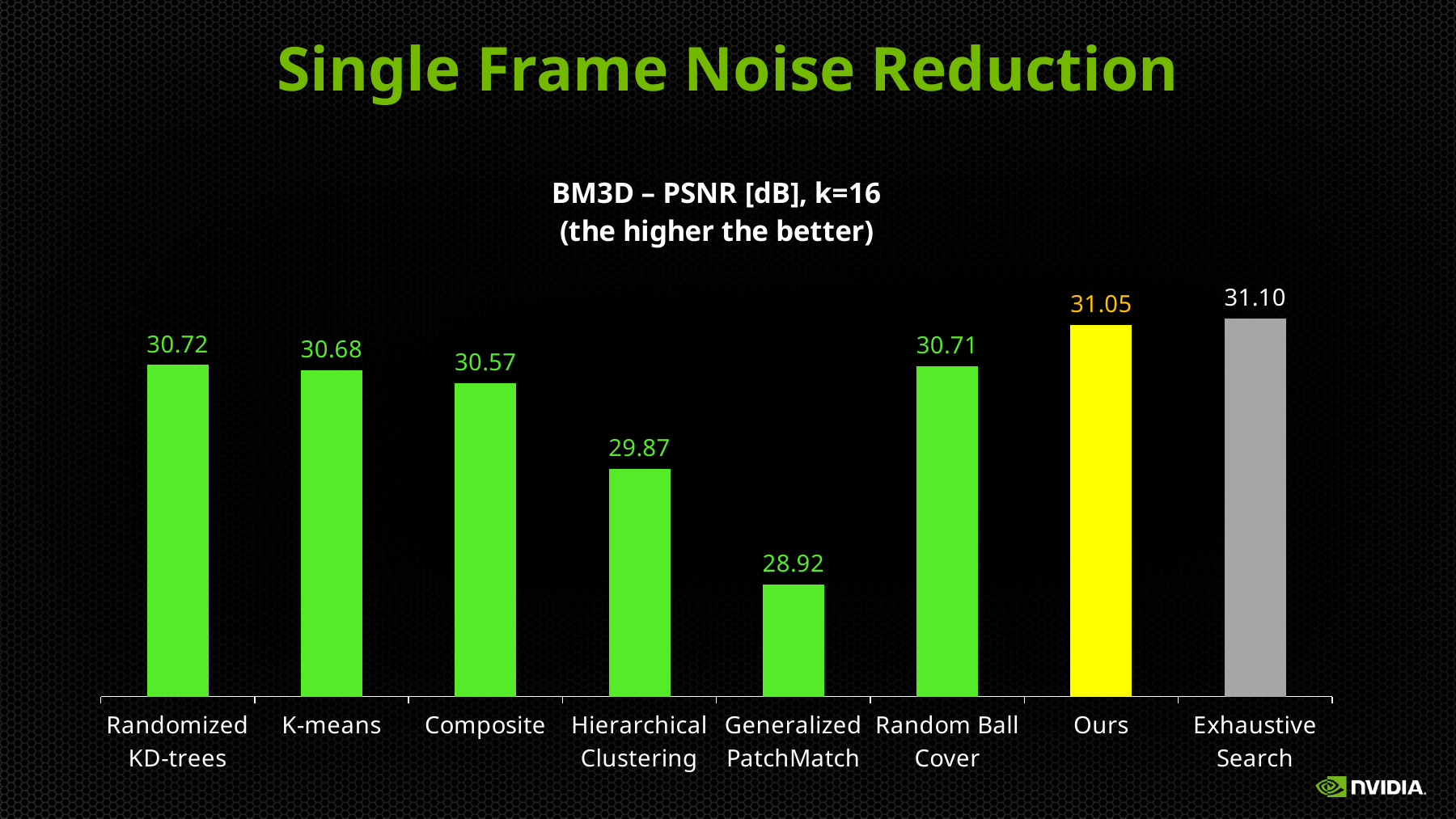
How many methods are shown in the chart? 8 What is the difference between the PSNR values of Randomized KD-trees and Generalized PatchMatch? 1.80 What colour is the bar for Ours? Yellow What is the title of the chart? BM3D – PSNR [dB], k=16 (the higher the better) What kind of chart is shown on the slide? Bar chart What is the PSNR value for Hierarchical Clustering? 29.87 What is the PSNR value for Generalized PatchMatch? 28.92 What is the difference between the PSNR values of Exhaustive Search and Ours? 0.05 Which has a higher PSNR value, Composite or Random Ball Cover? Random Ball Cover What is the PSNR value for Ours? 31.05 Which method has the lowest PSNR value? Generalized PatchMatch Which method has the highest PSNR value? Exhaustive Search